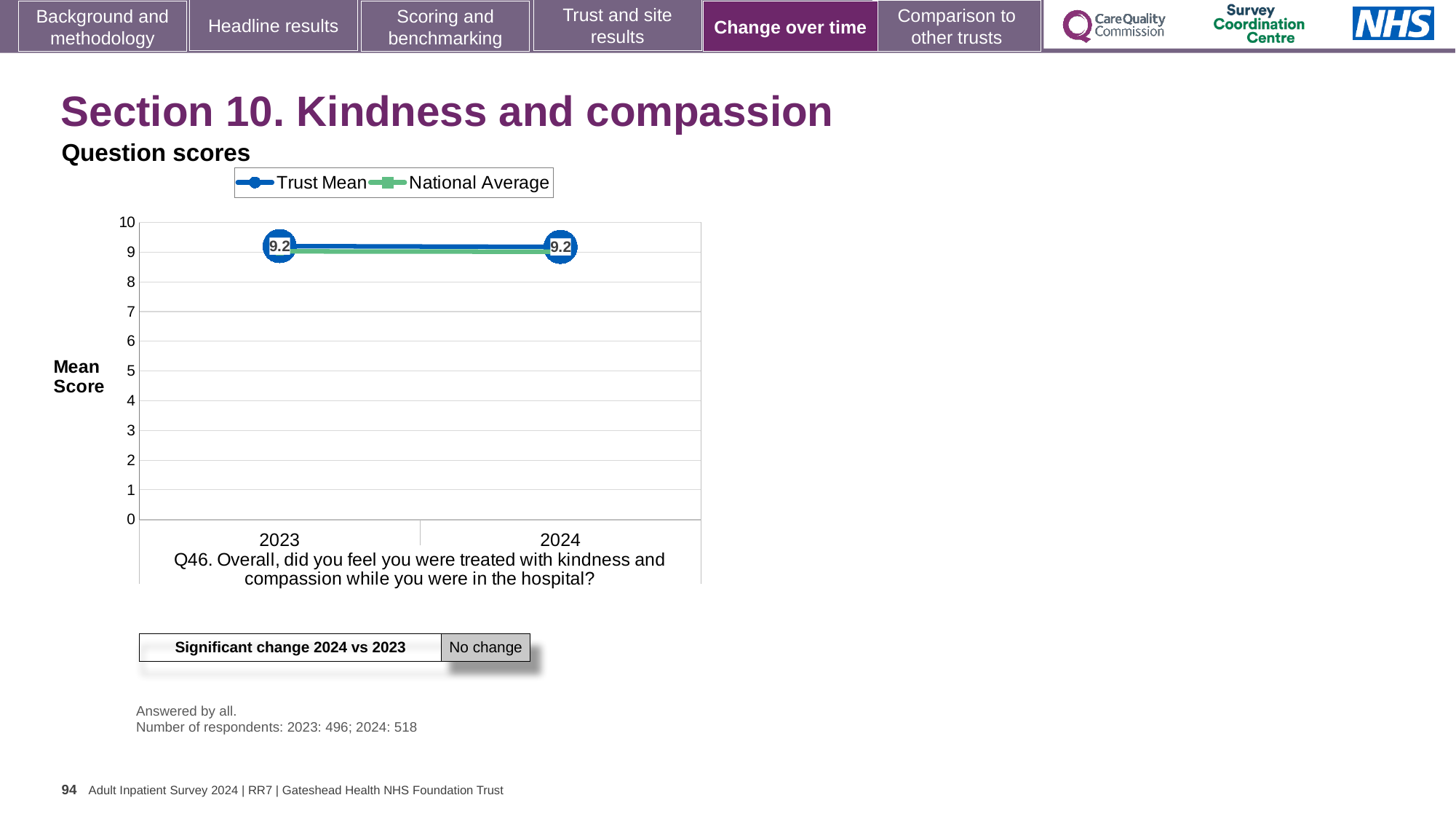
What is the Trust Mean score for 2023? 9.2 Is the National Average value for 2023 greater or less than 8? greater Is the National Average value for 2024 greater or less than 10? less What is the Trust Mean score for 2024? 9.2 What is the highest value shown on the y axis of the chart? 10 What is the difference between the Trust Mean score in 2024 and in 2023? 0 What kind of chart is shown on the slide? Line chart How many years are plotted on the x axis of the chart? 2 How many series does the chart legend list? 2 What are the two series named in the chart legend? Trust Mean and National Average Does the Trust Mean score rise, fall or stay the same from 2023 to 2024? Stays the same What is the label on the y axis of the chart? Mean Score